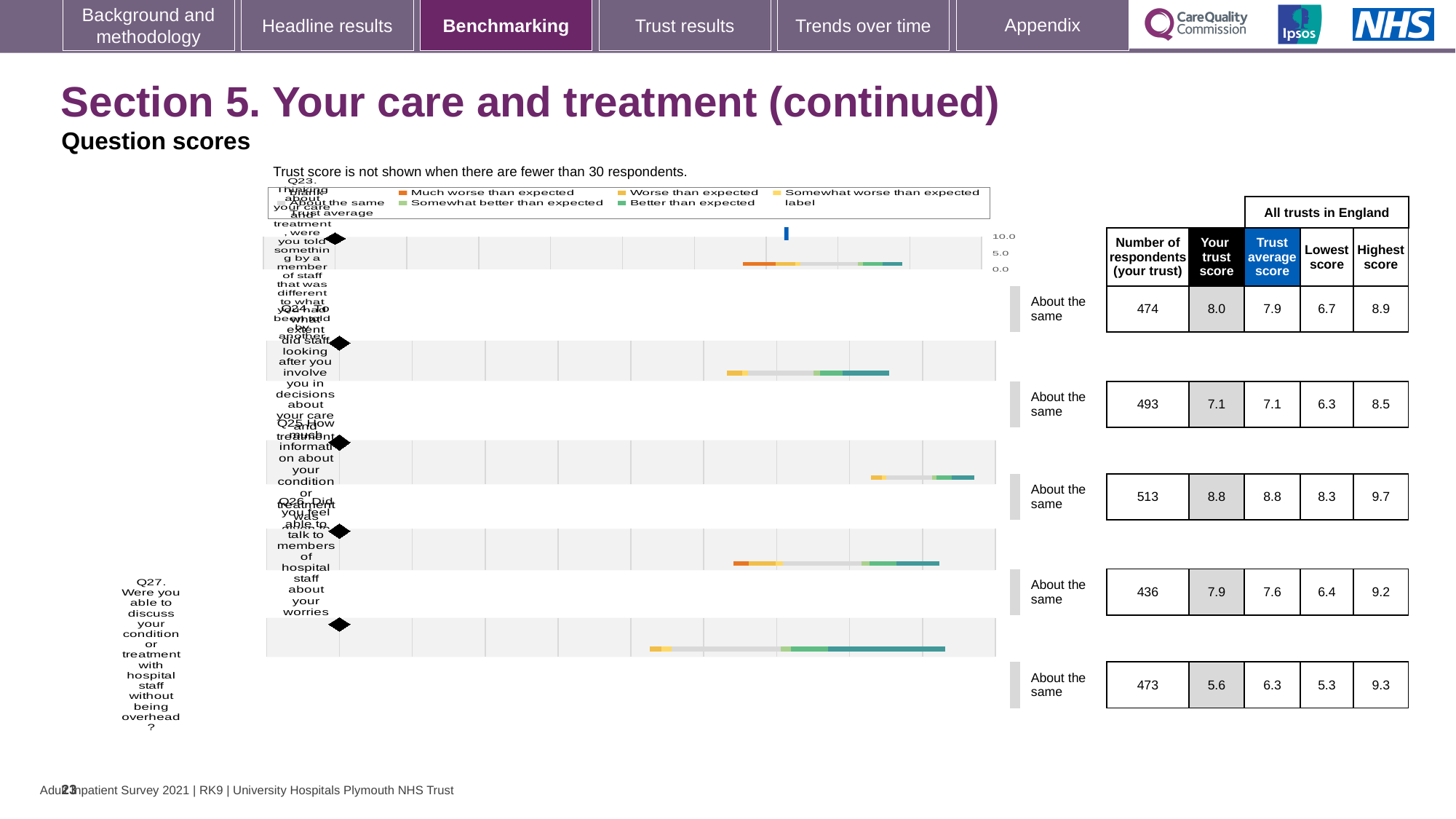
What is the 'Trust average score' for Q27 (discussing your condition or treatment without being overheard)? 6.3 What is the 'Your trust score' for Q25 (how much information about your condition or treatment was given to you)? 8.8 For Q23, which is larger: 'Your trust score' or the 'Trust average score'? Your trust score Which question has the highest 'Your trust score' on this slide? Q25 What kind of chart is used to show the question scores on this slide? Bar chart What benchmark category is shown for Q27 (discussing your condition or treatment without being overheard)? About the same Which question has the lowest 'Your trust score' on this slide? Q27 What is the 'Highest score' across all trusts in England for Q26 (talking to hospital staff about your worries and fears)? 9.2 How many respondents (your trust) are shown for Q24 (involving you in decisions about your care and treatment)? 493 How many questions (Q23 to Q27) are plotted on this slide? 5 What is the 'Lowest score' across all trusts in England for Q23 (being told something different by another member of staff)? 6.7 For Q26, what is the difference between 'Your trust score' and the 'Trust average score'? 0.3